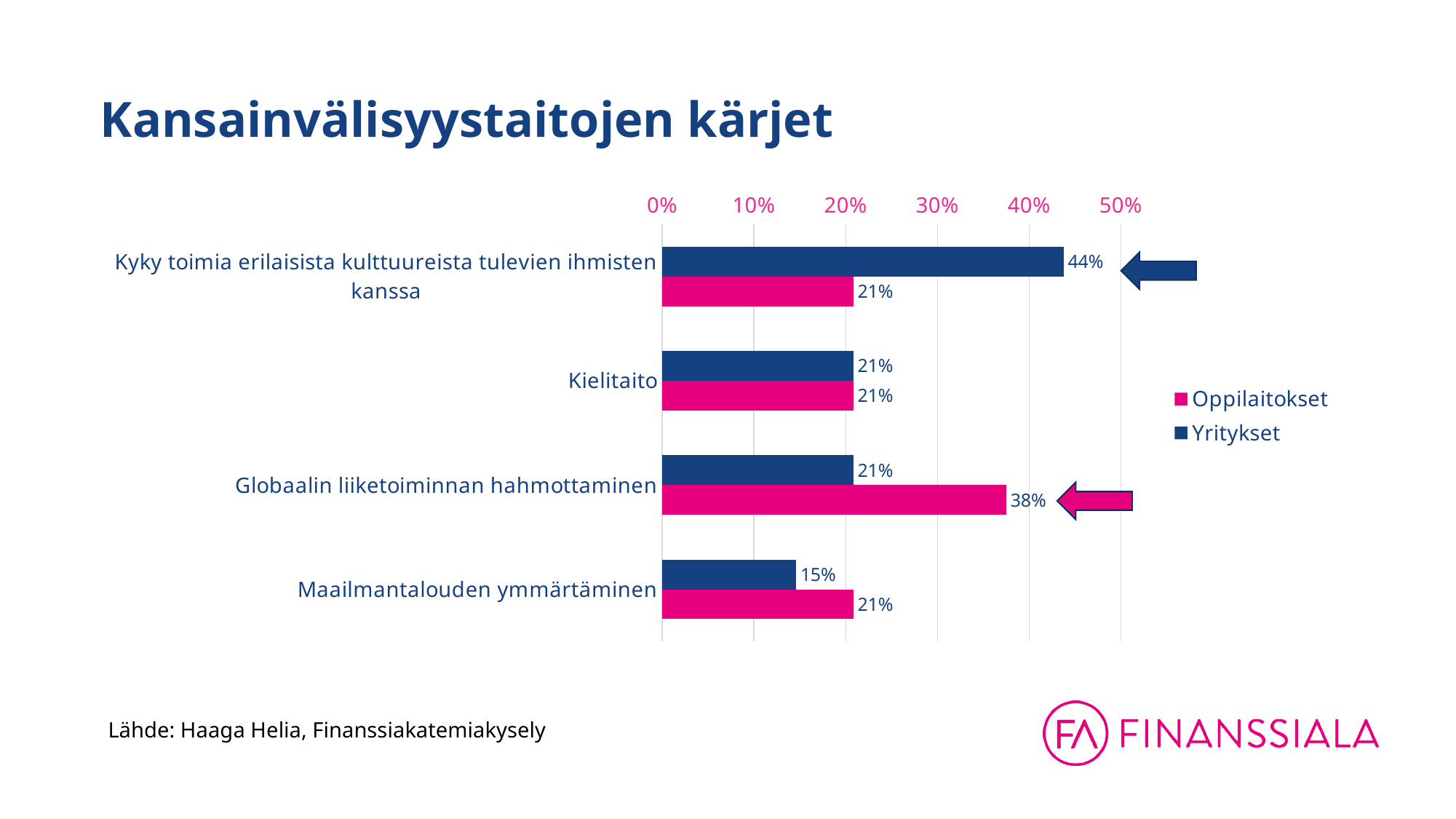
How many series does the legend list? 2 What is the Yritykset value for "Kyky toimia erilaisista kulttuureista tulevien ihmisten kanssa"? 44% What is the Oppilaitokset value for "Kielitaito"? 21% For "Globaalin liiketoiminnan hahmottaminen", which series has the larger value, Oppilaitokset or Yritykset? Oppilaitokset Which category has the highest Oppilaitokset value? Globaalin liiketoiminnan hahmottaminen Which category has the highest Yritykset value? Kyky toimia erilaisista kulttuureista tulevien ihmisten kanssa Which category has the lowest Yritykset value? Maailmantalouden ymmärtäminen What is the Oppilaitokset value for "Globaalin liiketoiminnan hahmottaminen"? 38% What kind of chart is shown on the slide? Bar chart What is the Yritykset value for "Maailmantalouden ymmärtäminen"? 15% How many categories are shown on the chart? 4 What is the difference between the Yritykset and Oppilaitokset values for "Kyky toimia erilaisista kulttuureista tulevien ihmisten kanssa"? 23%